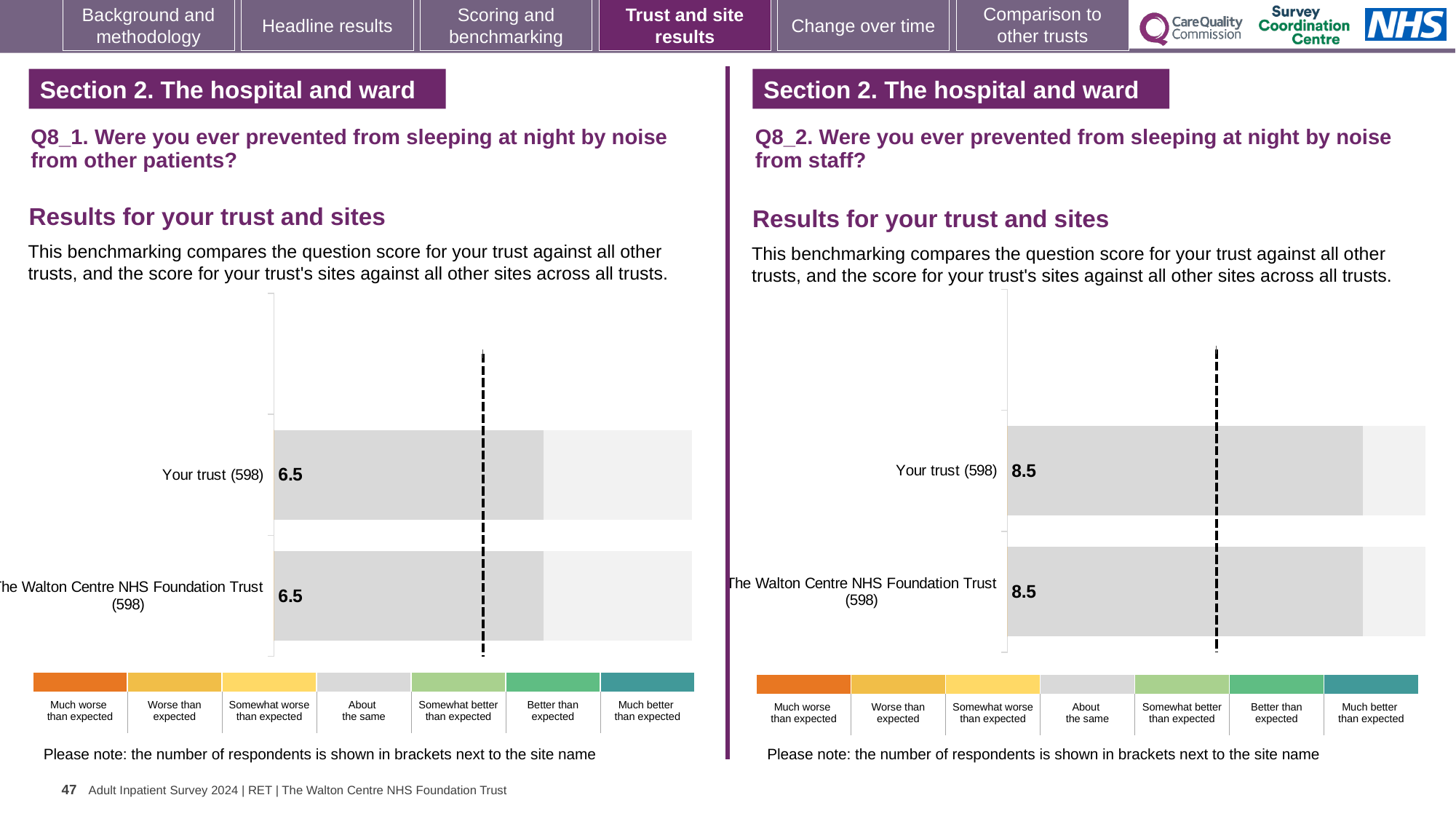
On the Q8_1 chart (left), what is the score for The Walton Centre NHS Foundation Trust (598)? 6.5 What kind of chart is used for the Q8_2 results (right)? Bar chart Which is larger: the Your trust score on the Q8_1 chart (left) or the Your trust score on the Q8_2 chart (right)? Q8_2 (8.5) On the Q8_1 chart (left), what is the difference between the score for Your trust and the score for The Walton Centre NHS Foundation Trust? 0 On the Q8_2 chart (right), what is the score for The Walton Centre NHS Foundation Trust (598)? 8.5 How many categories does the colour key below the Q8_1 chart (left) list, from 'Much worse than expected' to 'Much better than expected'? 7 How many respondents are shown in brackets next to Your trust on the Q8_1 chart (left)? 598 On the Q8_2 chart (right), what is the difference between the score for Your trust and the score for The Walton Centre NHS Foundation Trust? 0 How many bars are plotted on the Q8_1 chart (left)? 2 How many bars are plotted on the Q8_2 chart (right)? 2 On the Q8_2 chart (right), what is the score for Your trust (598)? 8.5 On the Q8_1 chart (left), what is the score for Your trust (598)? 6.5